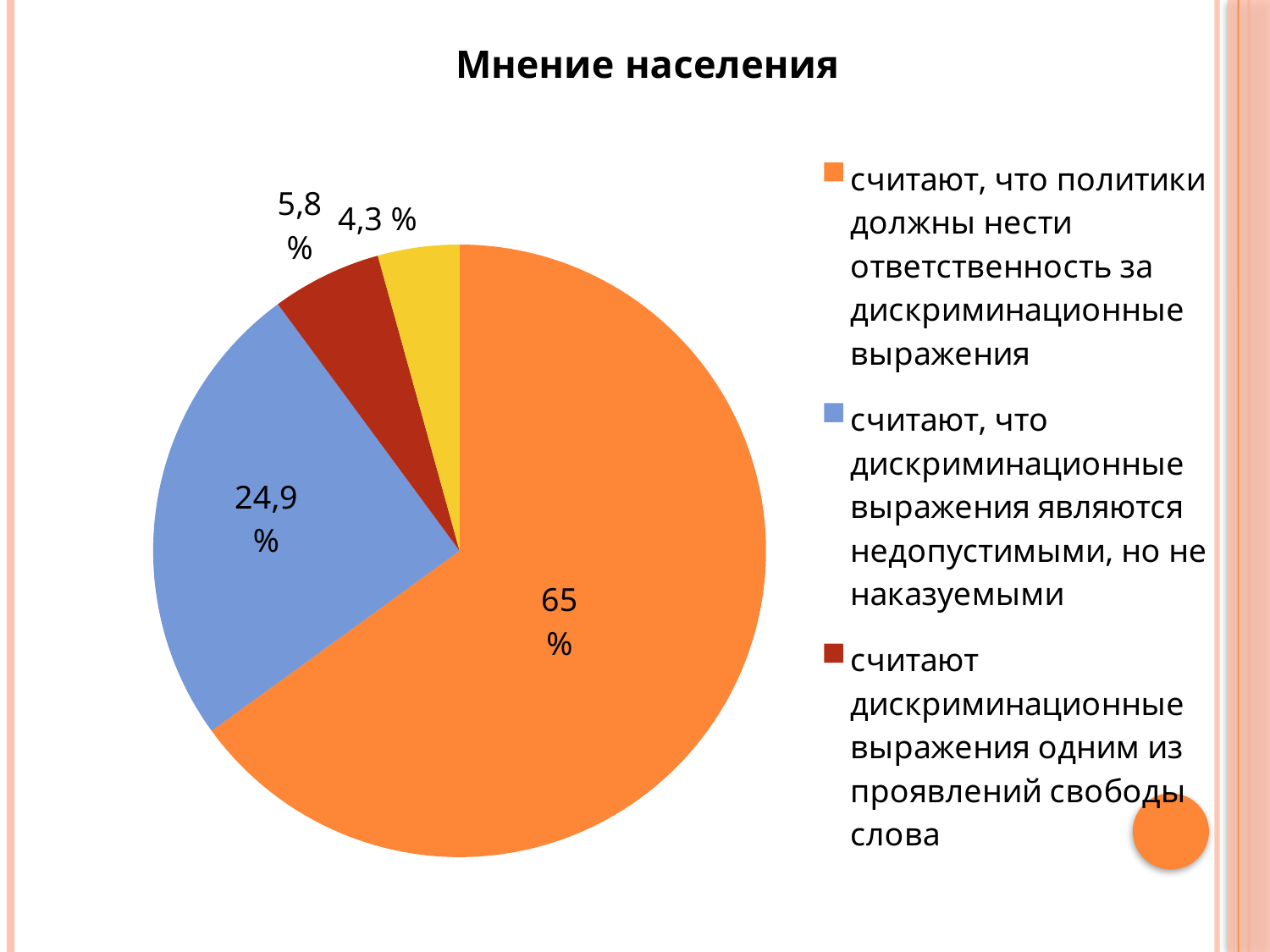
What is the title of the chart? Мнение населения What is the difference between the 65 % slice and the 24,9 % slice? 40,1 percentage points What colour is the slice representing those who consider discriminatory statements a manifestation of freedom of speech? Dark red How many entries does the legend list? 3 Which is larger: the share who consider discriminatory statements unacceptable but not punishable, or the share who consider them a manifestation of freedom of speech? Unacceptable but not punishable (24,9 %) How many slices does the pie chart have? 4 What share of respondents consider discriminatory statements unacceptable but not punishable (считают, что дискриминационные выражения являются недопустимыми, но не наказуемыми)? 24,9 % Which legend category has the largest slice of the pie? считают, что политики должны нести ответственность за дискриминационные выражения What is the value of the smallest slice of the pie? 4,3 % What share of respondents consider discriminatory statements a manifestation of freedom of speech (считают дискриминационные выражения одним из проявлений свободы слова)? 5,8 % What share of respondents consider that politicians should bear responsibility for discriminatory statements (считают, что политики должны нести ответственность за дискриминационные выражения)? 65 % What kind of chart is shown on the slide? Pie chart